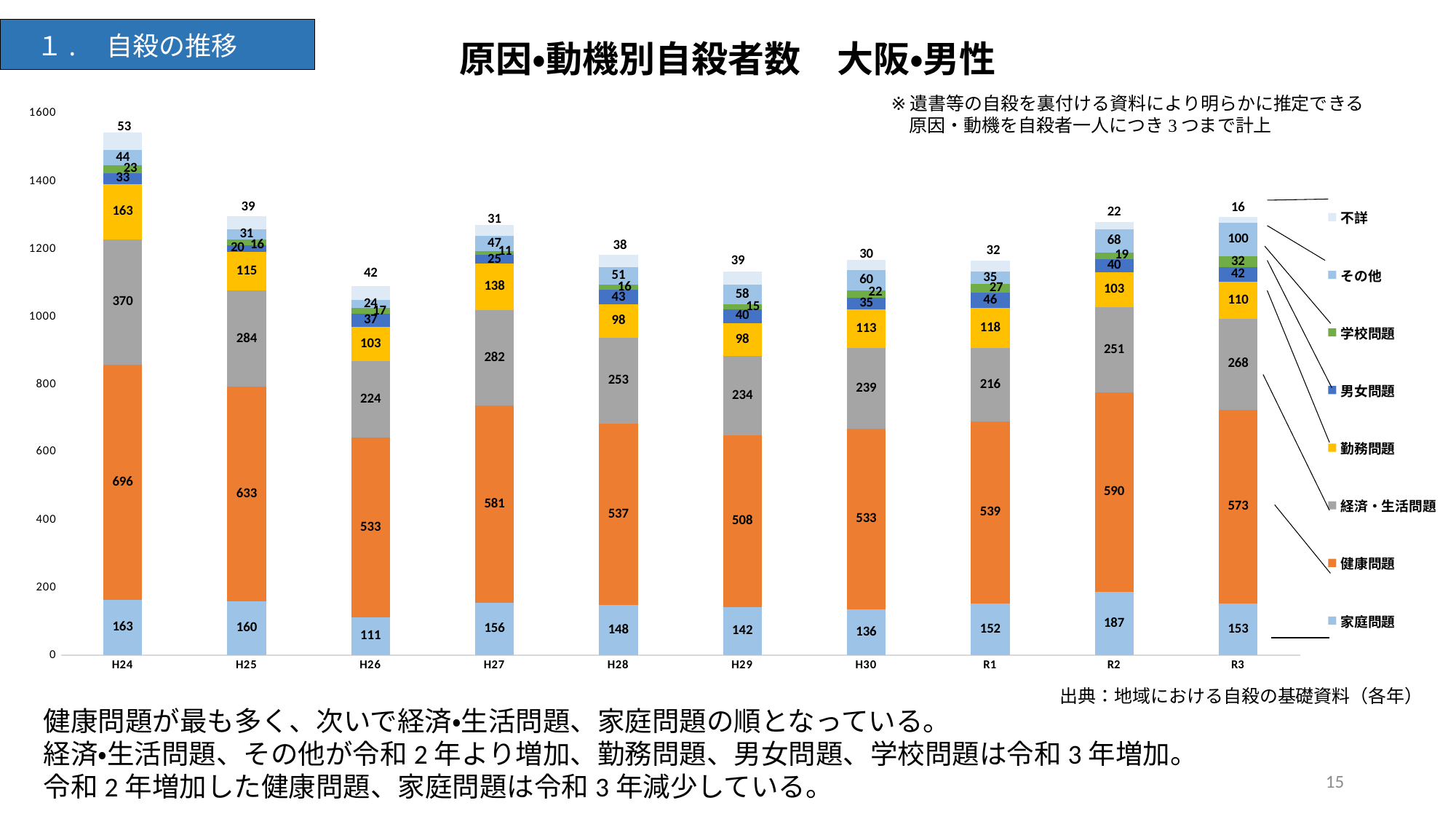
Which is larger, the 勤務問題 value for H27 or for H28? H27 How many series does the legend list? 8 What is the value for 健康問題 in H24? 696 In which year is the value for 健康問題 the highest? H24 What is the value for 家庭問題 in R2? 187 What kind of chart is shown? Stacked bar chart In which year is the value for 家庭問題 the lowest? H26 What is the total of the stacked bar for H24? 1545 What is the difference between the 健康問題 values for R2 and R3? 17 How many years are shown on the x axis? 10 What is the value for その他 in R3? 100 What is the value for 経済・生活問題 in R3? 268